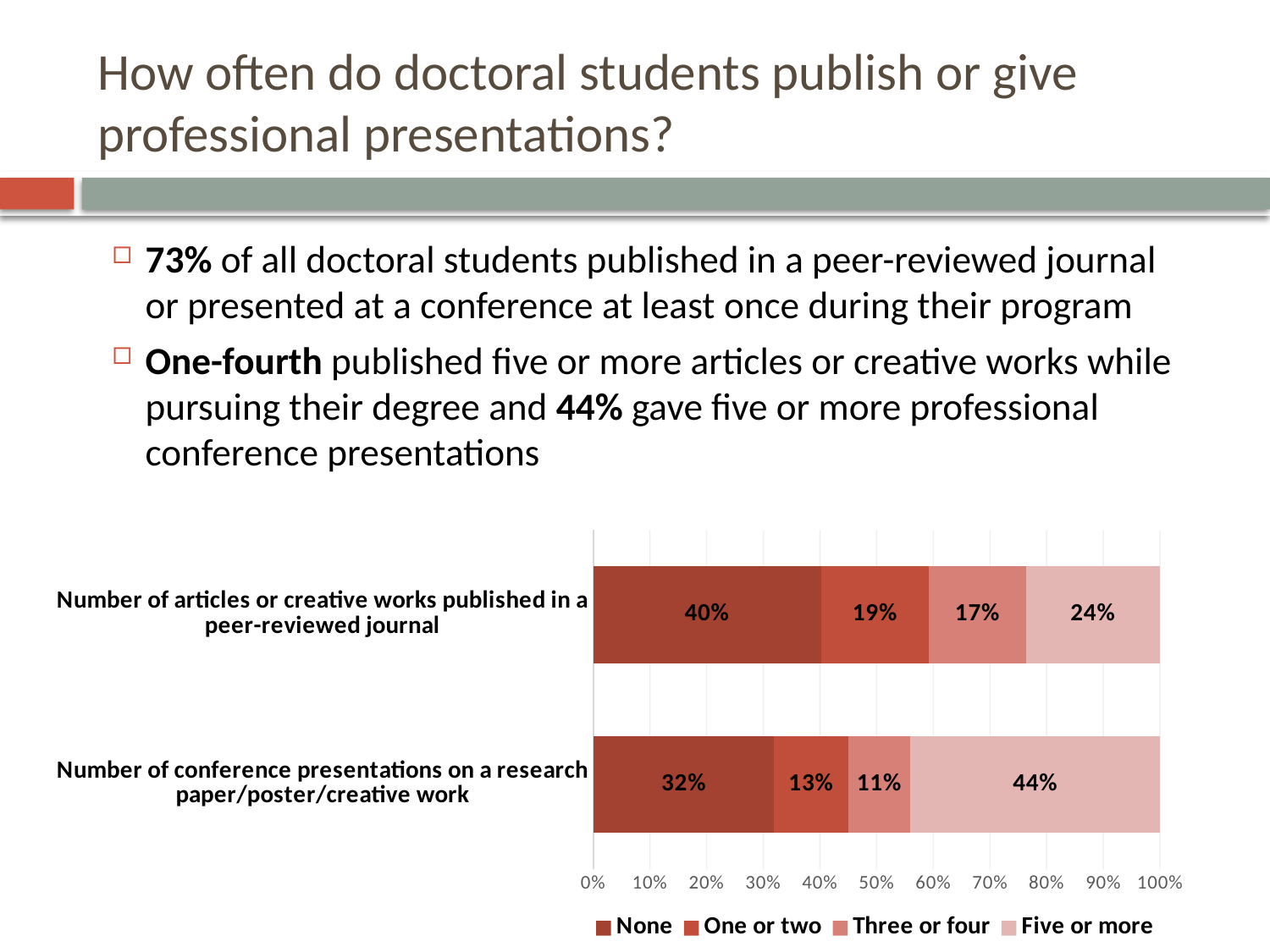
What percentage of doctoral students gave five or more conference presentations on a research paper/poster/creative work? 44% What percentage of doctoral students published three or four articles or creative works in a peer-reviewed journal? 17% What percentage of doctoral students published no articles or creative works in a peer-reviewed journal? 40% What percentage of doctoral students gave one or two conference presentations? 13% What is the total of the segments in the bar for number of articles or creative works published in a peer-reviewed journal? 100% What is the difference between the 'None' share for articles published in a peer-reviewed journal and the 'None' share for conference presentations? 8% What kind of chart is shown on the slide? Stacked bar chart How many series does the legend list? 4 How many categories (bars) are shown in the chart? 2 Which category has the smallest share for the number of conference presentations bar? Three or four Which is larger: the 'Five or more' share for articles published in a peer-reviewed journal or the 'Five or more' share for conference presentations? Conference presentations Which category has the largest share for the number of conference presentations bar? Five or more